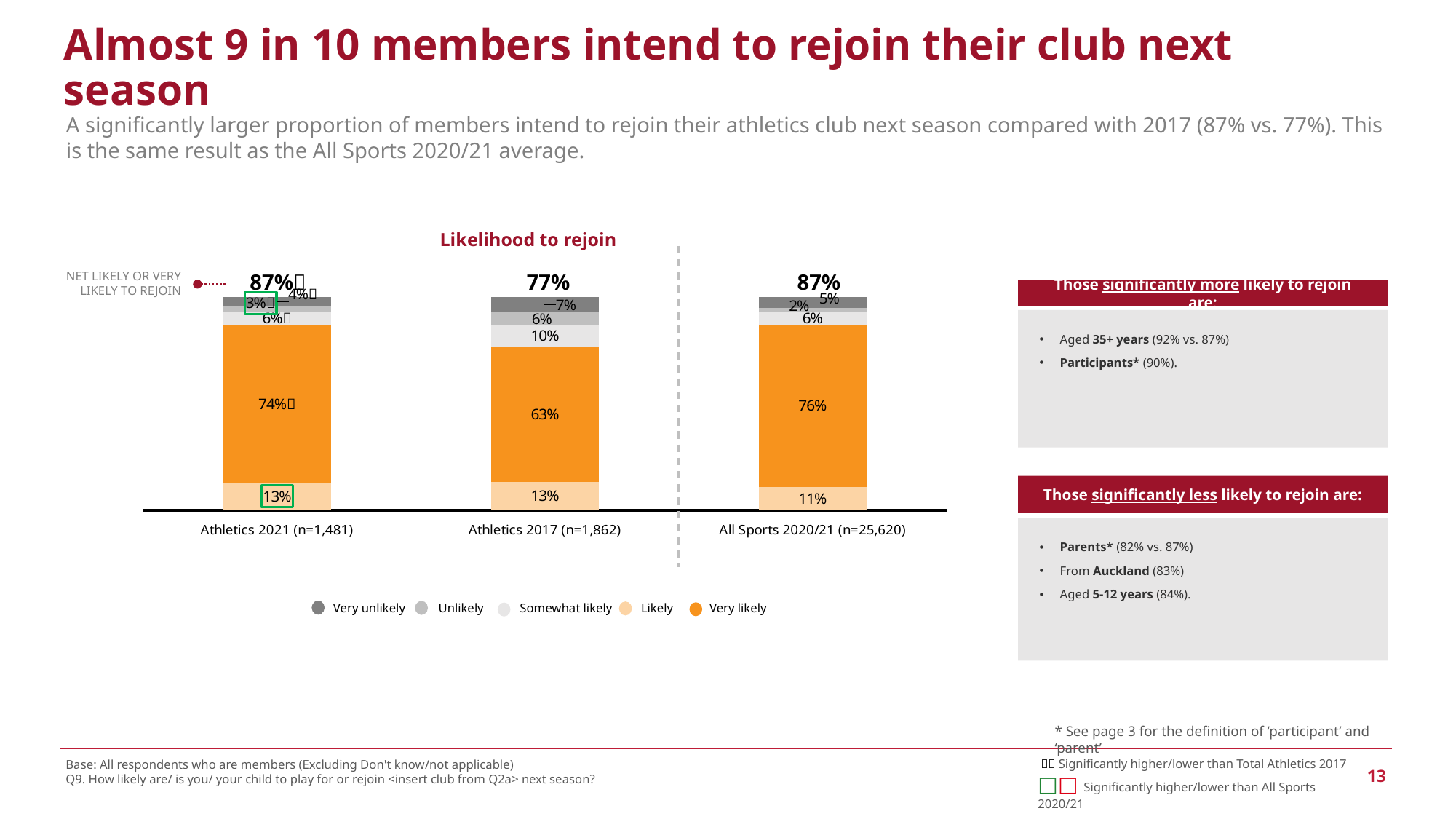
Which category has the lowest net likely or very likely to rejoin figure? Athletics 2017 (n=1,862) Is the 'Somewhat likely' value larger for Athletics 2017 (n=1,862) or for All Sports 2020/21 (n=25,620)? Athletics 2017 (n=1,862) What is the net likely or very likely to rejoin figure for Athletics 2017 (n=1,862)? 77% What is the 'Very likely' value for Athletics 2017 (n=1,862)? 63% How many categories (bars) are shown in the chart? 3 Which category has the highest 'Very likely' value? All Sports 2020/21 (n=25,620) What is the 'Somewhat likely' value for Athletics 2017 (n=1,862)? 10% What is the 'Very likely' value for Athletics 2021 (n=1,481)? 74% What is the difference between the 'Very likely' values for Athletics 2021 (n=1,481) and Athletics 2017 (n=1,862)? 11 percentage points How many series does the legend list? 5 What type of chart is shown on the slide? Stacked bar chart What is the 'Likely' value for All Sports 2020/21 (n=25,620)? 11%